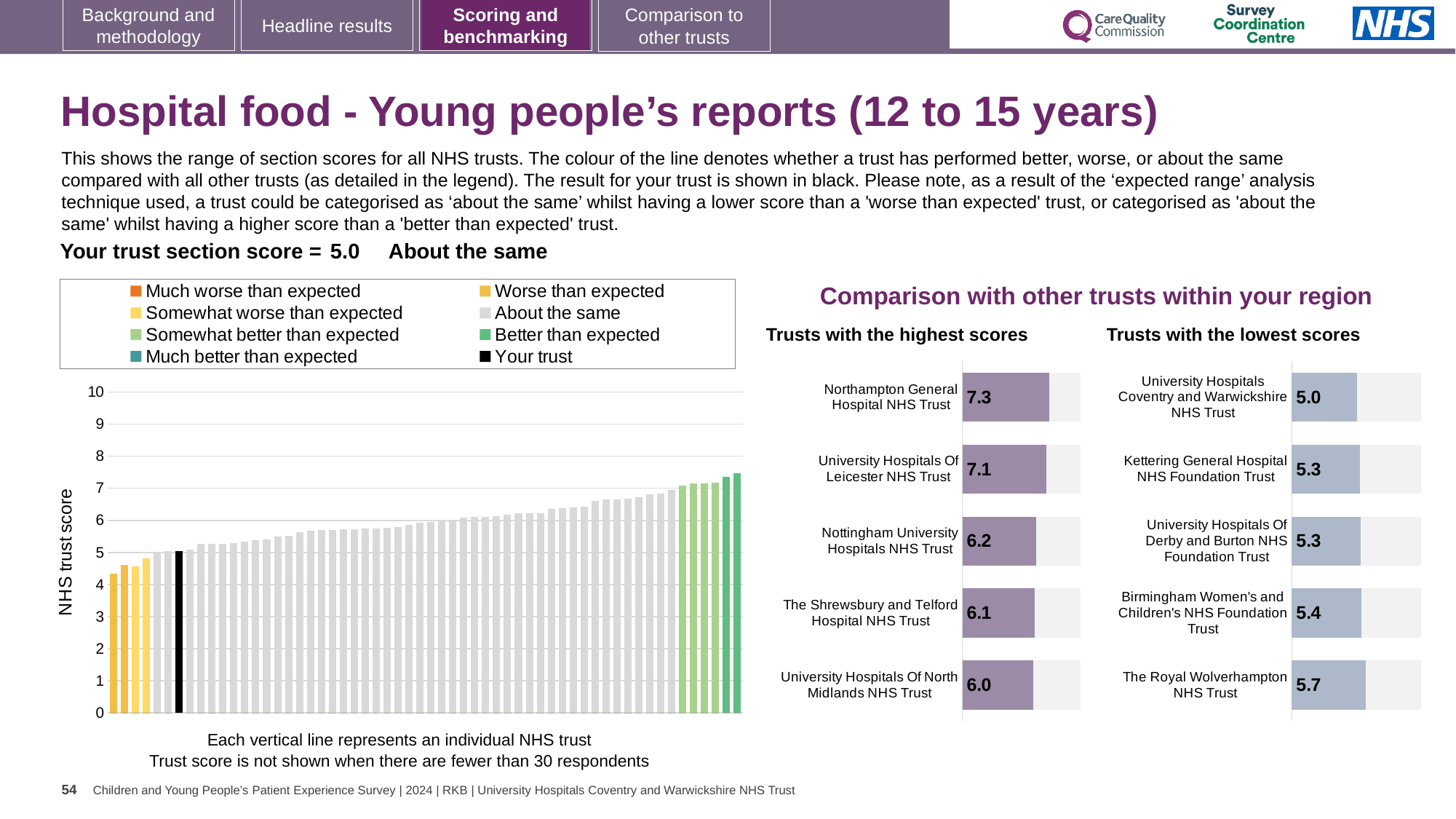
In the 'Trusts with the lowest scores' chart, what is the difference between the scores of The Royal Wolverhampton NHS Trust and University Hospitals Coventry and Warwickshire NHS Trust? 0.7 How many entries does the legend of the NHS trust score chart list? 8 In the 'Trusts with the highest scores' chart, what is the score for Northampton General Hospital NHS Trust? 7.3 In the 'Trusts with the highest scores' chart, which has the higher score: University Hospitals Of Leicester NHS Trust or The Shrewsbury and Telford Hospital NHS Trust? University Hospitals Of Leicester NHS Trust In the 'Trusts with the highest scores' chart, what is the difference between the scores of Northampton General Hospital NHS Trust and University Hospitals Of North Midlands NHS Trust? 1.3 In the 'Trusts with the lowest scores' chart, what is the score for The Royal Wolverhampton NHS Trust? 5.7 In the 'Trusts with the lowest scores' chart, which trust has the lowest score? University Hospitals Coventry and Warwickshire NHS Trust How many trusts are listed in the 'Trusts with the lowest scores' chart? 5 In the NHS trust score chart, do the bars rise or fall from left to right? Rise In the 'Trusts with the highest scores' chart, what is the score for Nottingham University Hospitals NHS Trust? 6.2 In the NHS trust score chart, is the value of the tallest bar greater or less than 7? greater What kind of chart is the NHS trust score chart on the left? Bar chart